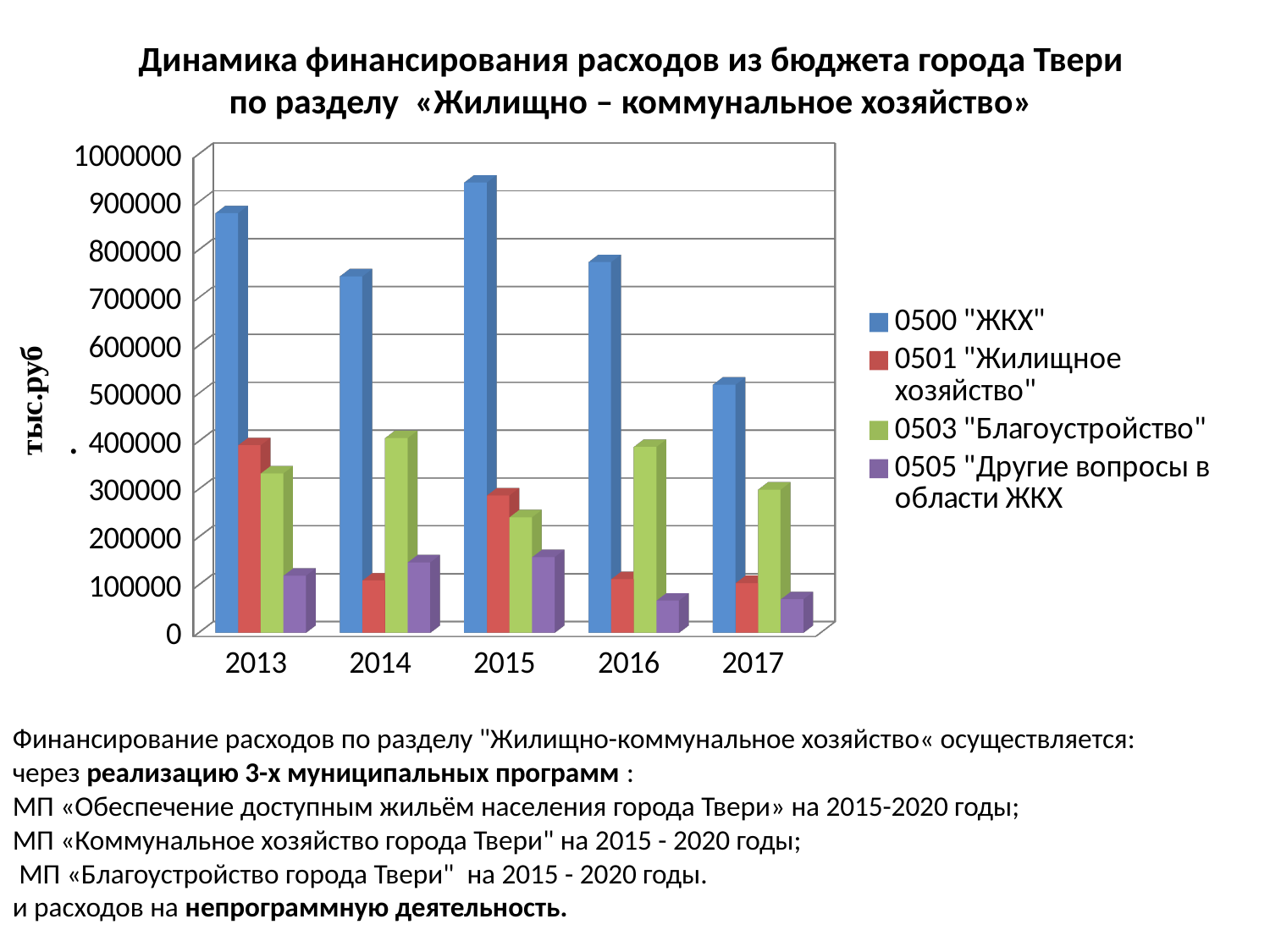
Which year has the larger value for 0503 "Благоустройство": 2014 or 2015? 2014 What is the label on the vertical axis of the chart? тыс.руб How many years are shown on the x axis of the chart? 5 In which year is the value for 0500 "ЖКХ" the highest? 2015 In which year is the value for 0501 "Жилищное хозяйство" the highest? 2013 Does the value for 0500 "ЖКХ" rise or fall from 2015 to 2017? fall Is the value for 0500 "ЖКХ" in 2017 greater or less than 600000? less In which year is the value for 0500 "ЖКХ" the lowest? 2017 Is the value for 0505 "Другие вопросы в области ЖКХ" in 2016 greater or less than 100000? less What kind of chart is shown on the slide? bar chart Is the value for 0500 "ЖКХ" in 2015 greater or less than 900000? greater How many series does the chart legend list? 4